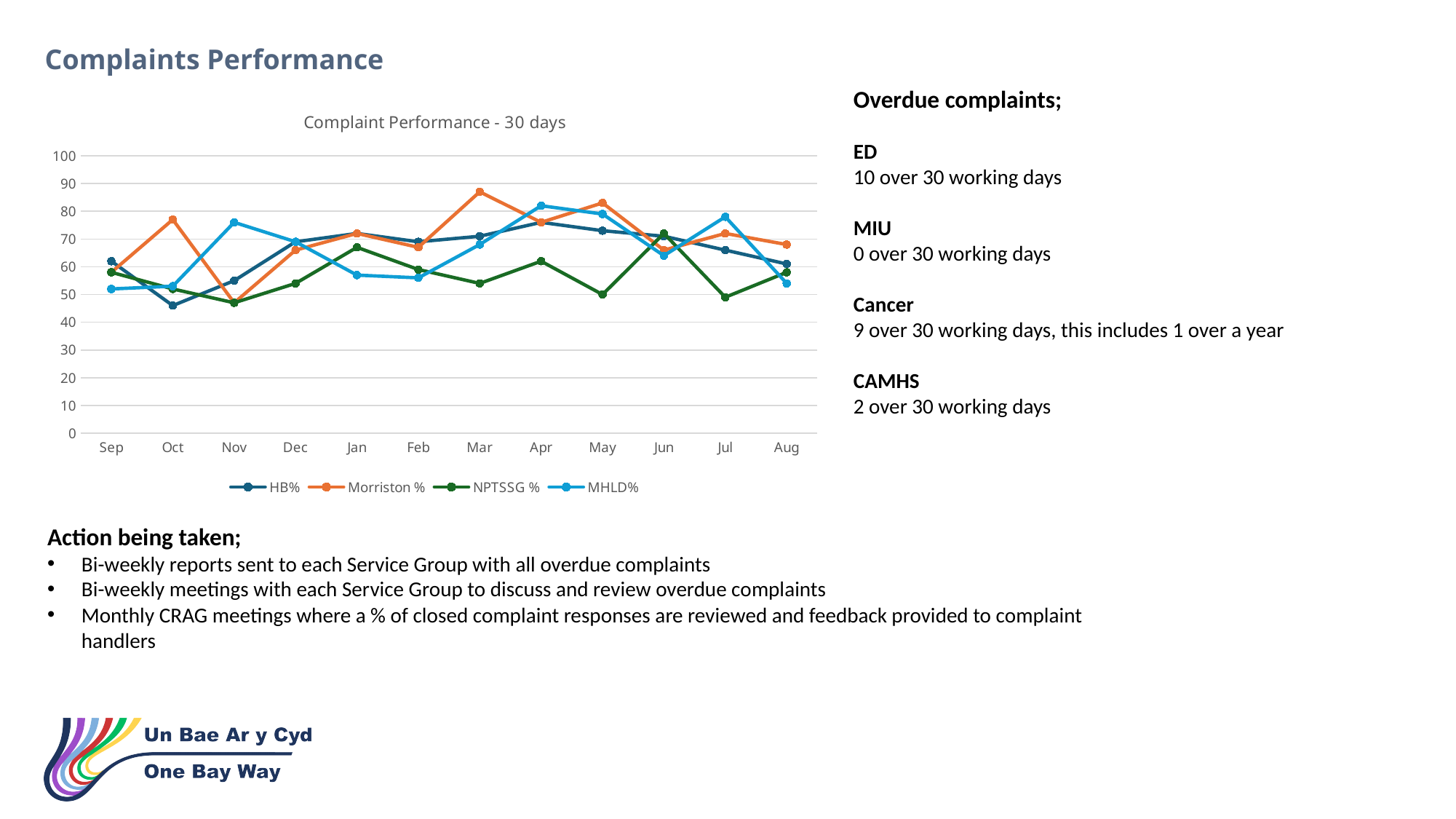
How many series does the chart's legend list? 4 Which series has the highest value in Mar? Morriston % How many months are plotted along the x axis of the chart? 12 Which series has the lowest value in Jul? NPTSSG % What type of chart is shown on the slide? Line chart Is the value for HB% in Oct greater or less than 50? less What is the title of the chart? Complaint Performance - 30 days Is the value for MHLD% in Nov greater or less than 70? greater Which series are listed in the chart's legend? HB%, Morriston %, NPTSSG %, MHLD% Is the value for Morriston % in Mar greater or less than 80? greater In Apr, which is higher: MHLD% or NPTSSG %? MHLD%